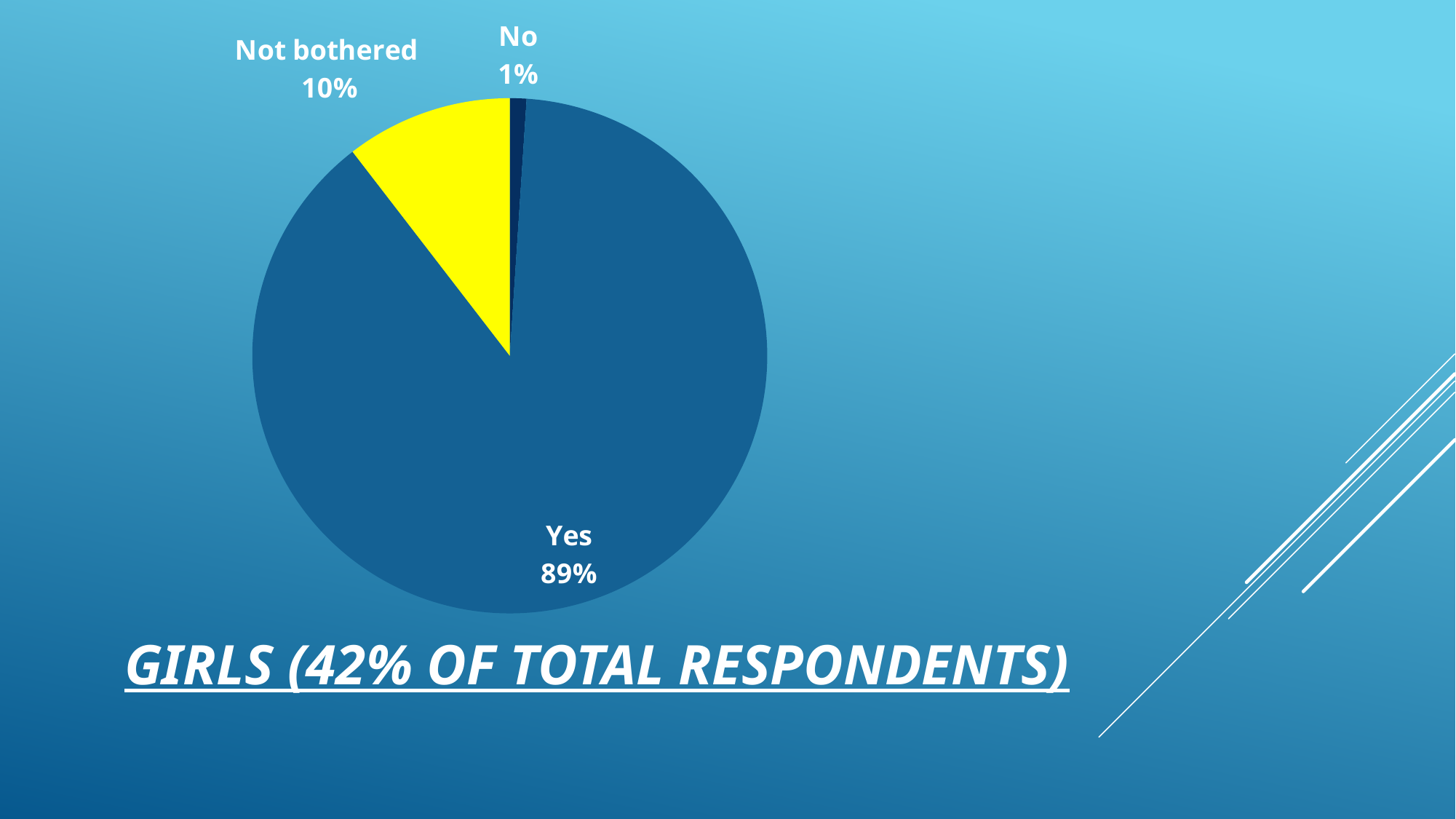
What share of the pie does the Not bothered slice represent? 10% What is the difference in percentage points between the Yes slice and the Not bothered slice? 79 Which is larger, the Not bothered slice or the No slice? Not bothered What colour is the Not bothered slice? yellow What share of the pie does the Yes slice represent? 89% Which slice of the pie is the largest? Yes What kind of chart is shown on the slide? pie chart What share of the pie does the No slice represent? 1% What is the title text shown below the pie chart? GIRLS (42% OF TOTAL RESPONDENTS) What is the difference in percentage points between the Not bothered slice and the No slice? 9 Which slice of the pie is the smallest? No How many slices does the pie chart have? 3